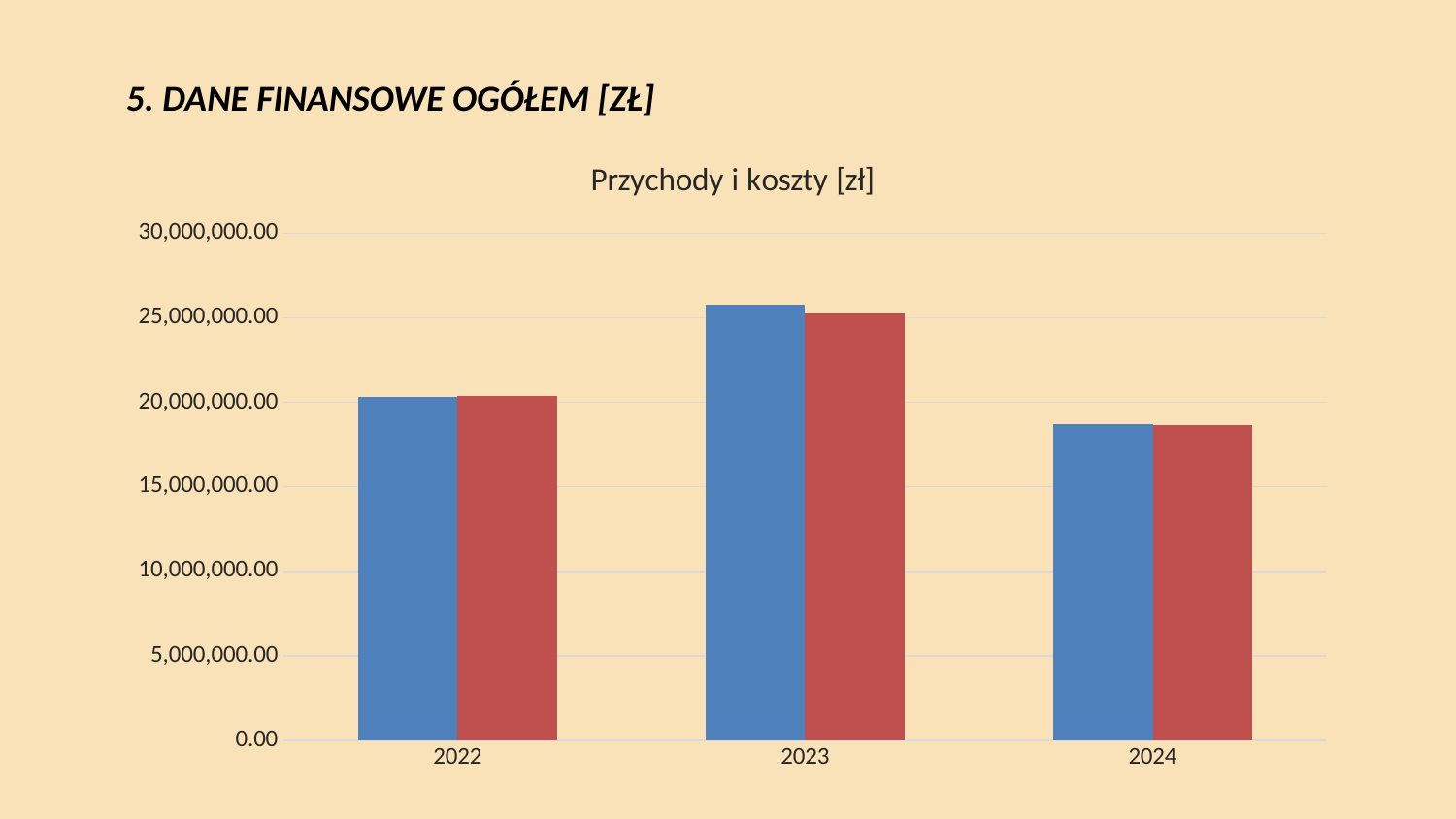
Is the value of the red bar for 2024 greater or less than 15,000,000.00? greater Which year has the shortest bars in the chart? 2024 Is the value of the blue bar for 2024 greater or less than 20,000,000.00? less How many years are shown on the x axis of the chart? 3 Which is larger, the blue bar for 2023 or the blue bar for 2024? the blue bar for 2023 How many bars are plotted for each year in the chart? 2 Is the value of the red bar for 2022 greater or less than 25,000,000.00? less What is the title of the chart? Przychody i koszty [zł] What colours are the two bar series in the chart? blue and red What type of chart is shown on the slide? bar chart Which year has the tallest bars in the chart? 2023